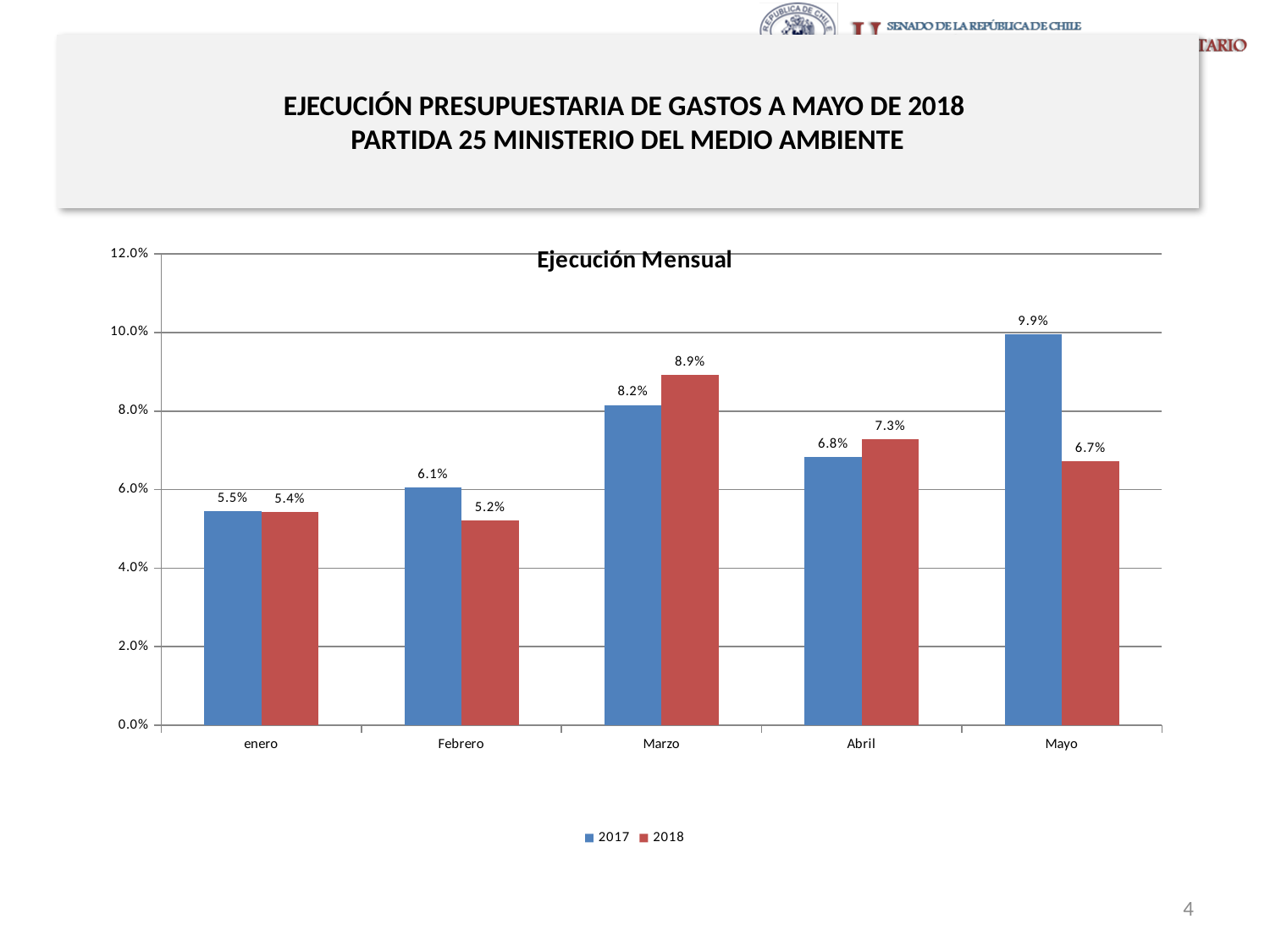
What is the title of the chart? Ejecución Mensual What kind of chart is shown? bar chart What is the value for 2018 in Abril? 7.3% Is the 2017 value for Abril greater or less than 8.0%? less Which is larger in Marzo, the 2017 value or the 2018 value? 2018 What is the difference between the 2017 and 2018 values in Mayo? 3.2% What is the value for 2017 in Marzo? 8.2% What is the value for 2018 in Mayo? 6.7% Which month has the highest value for the 2017 series? Mayo How many series does the legend list? 2 How many months are shown on the x axis? 5 Which month has the lowest value for the 2018 series? Febrero